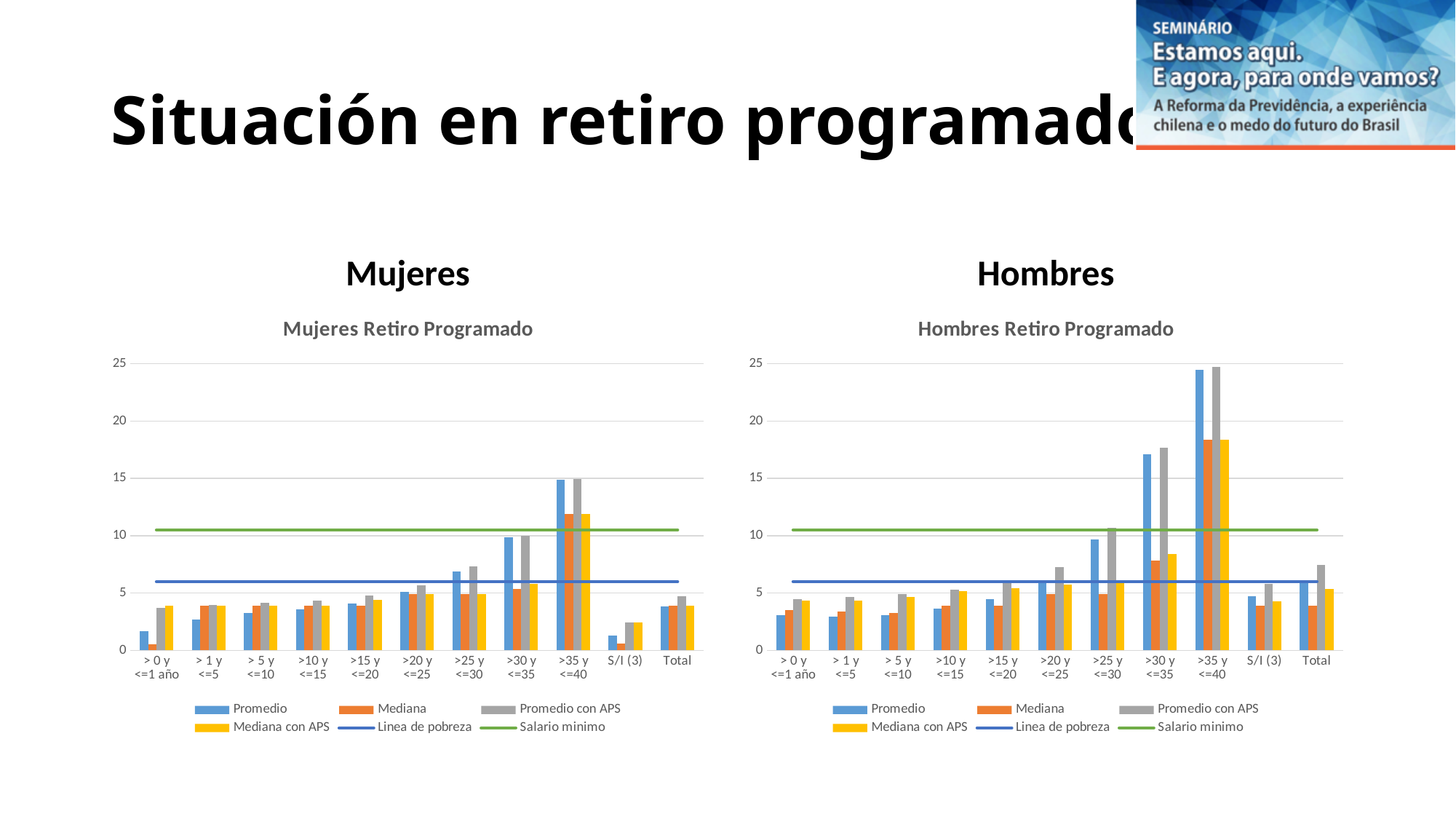
What colour is the Salario minimo line in the Mujeres Retiro Programado chart? green In the Mujeres Retiro Programado chart, is the Promedio value for Total greater or less than 5? less In the Hombres Retiro Programado chart, which category has the highest Promedio value? >35 y <=40 How many series does the legend of the Hombres Retiro Programado chart list? 6 In the Hombres Retiro Programado chart, do the Promedio values generally rise or fall from >0 y <=1 año to >35 y <=40? rise In the Mujeres Retiro Programado chart, is the Promedio value for >35 y <=40 greater or less than 10? greater What kind of chart is the Mujeres Retiro Programado chart? combination bar and line chart In the Hombres Retiro Programado chart, is the Promedio value for >30 y <=35 greater or less than 15? greater Which is larger: the Promedio value for >35 y <=40 in the Hombres Retiro Programado chart or in the Mujeres Retiro Programado chart? Hombres Retiro Programado How many categories are shown on the x axis of the Mujeres Retiro Programado chart? 11 In the Mujeres Retiro Programado chart, which category has the highest Promedio value? >35 y <=40